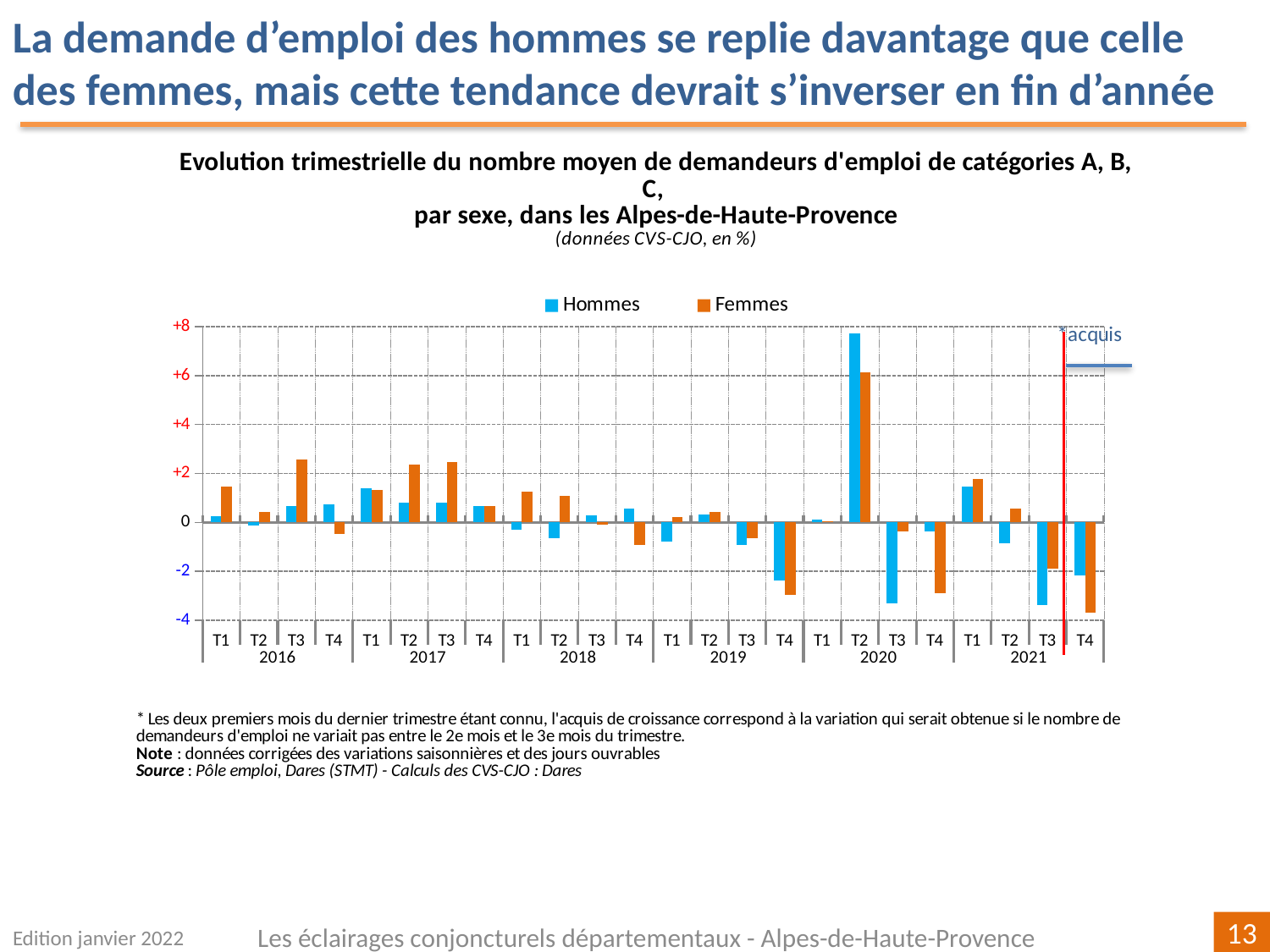
What are the two series named in the legend? Hommes and Femmes In which quarter is the Femmes value highest? T2 2020 Which colour represents the Femmes series? orange In which quarter is the Hommes value highest? T2 2020 What kind of chart is shown on the slide? bar chart Is the Hommes value for T2 2020 greater or less than +6? greater In T3 2016, which series has the larger value, Hommes or Femmes? Femmes How many series does the legend list? 2 In which quarter is the Femmes value lowest? T4 2021 In T2 2020, which series has the larger value, Hommes or Femmes? Hommes Is the Femmes value for T4 2021 greater or less than -2? less How many quarters (bar groups) are plotted along the x axis? 24